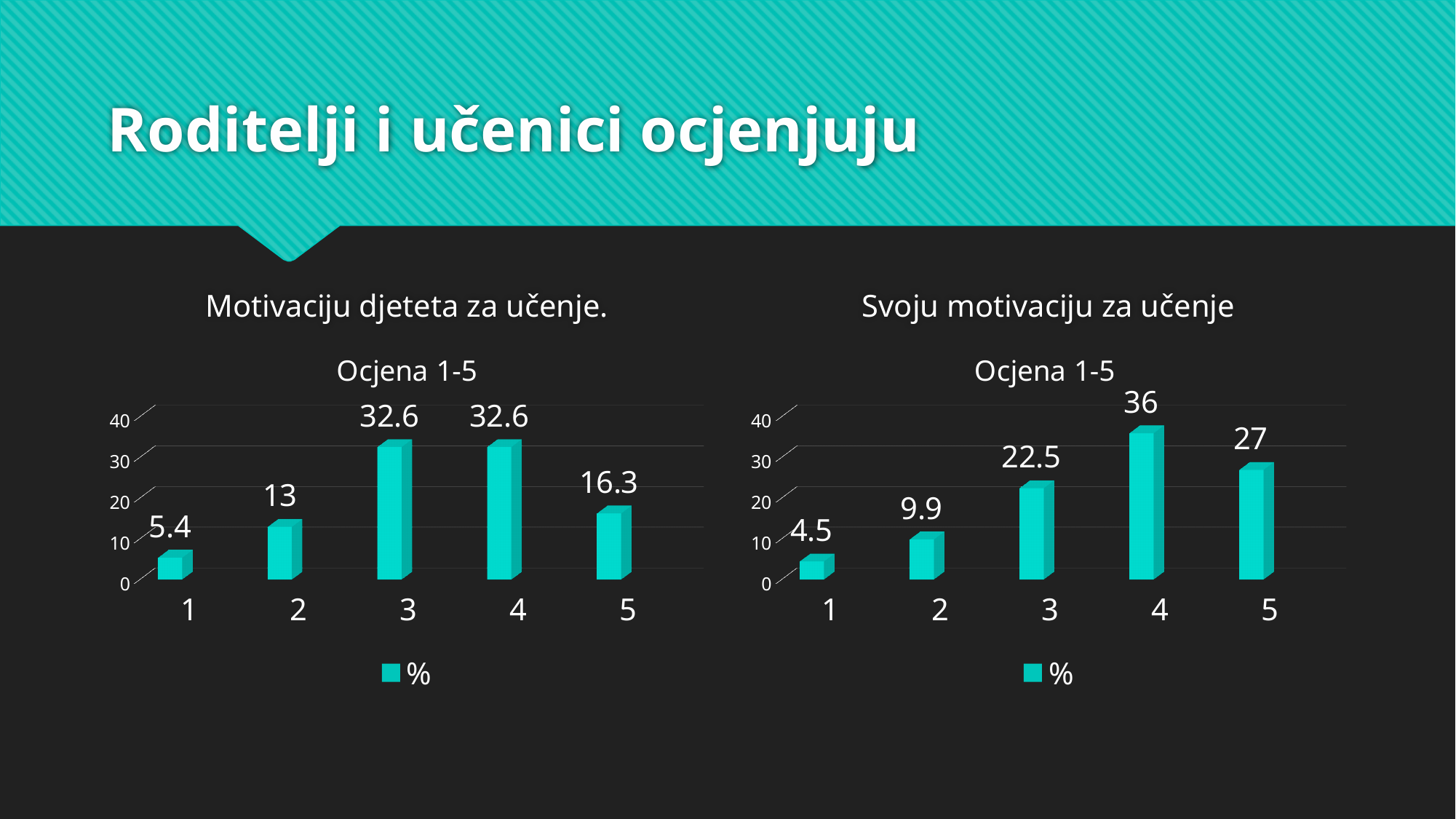
In the left chart (Motivaciju djeteta za učenje), what is the difference between the values for rating 2 and rating 1? 7.6 In the left chart (Motivaciju djeteta za učenje), what is the value for rating 5? 16.3 What type of chart is the left chart (Motivaciju djeteta za učenje)? bar chart In the right chart (Svoju motivaciju za učenje), which rating has the highest value? 4 In the left chart (Motivaciju djeteta za učenje), which is larger, the value for rating 2 or rating 5? 5 How many rating categories are shown on the x axis of the right chart (Svoju motivaciju za učenje)? 5 What is the legend entry shown below the right chart (Svoju motivaciju za učenje)? % In the right chart (Svoju motivaciju za učenje), what is the value for rating 2? 9.9 In the right chart (Svoju motivaciju za učenje), what is the difference between the values for rating 4 and rating 5? 9 In the right chart (Svoju motivaciju za učenje), what is the value for rating 4? 36 In the left chart (Motivaciju djeteta za učenje), what is the value for rating 3? 32.6 In the left chart (Motivaciju djeteta za učenje), which rating has the lowest value? 1